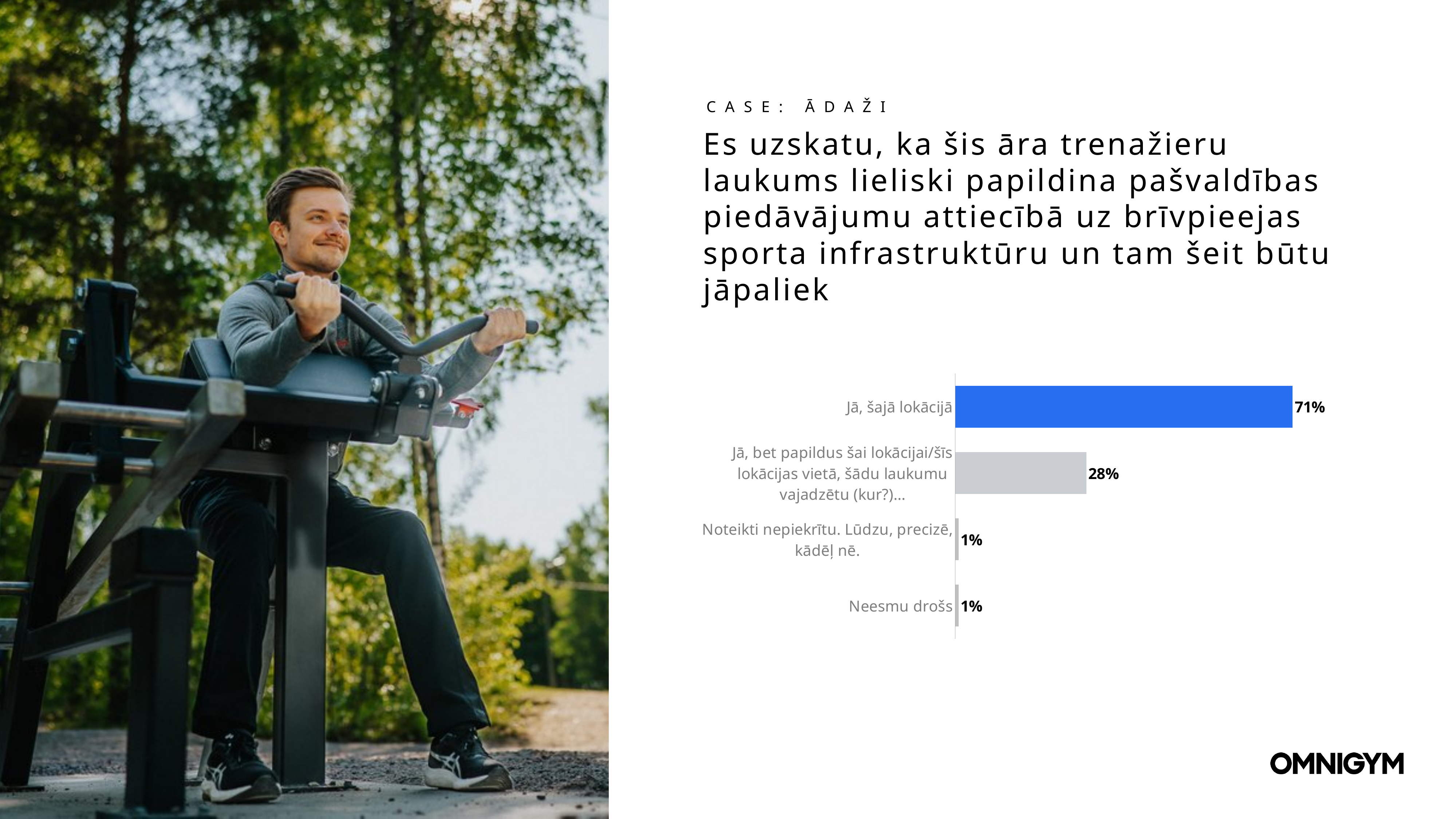
What is the value for "Noteikti nepiekrītu. Lūdzu, precizē, kādēļ nē."? 1% What kind of chart is shown on the slide? Bar chart Which case is named above the chart's statement? Ādaži What is the difference between the values for "Jā, šajā lokācijā" and "Jā, bet papildus šai lokācijai/šīs lokācijas vietā, šādu laukumu vajadzētu (kur?)..."? 43% What is the value for "Jā, bet papildus šai lokācijai/šīs lokācijas vietā, šādu laukumu vajadzētu (kur?)..."? 28% Which category has the highest value? Jā, šajā lokācijā What is the difference between the values for "Jā, bet papildus šai lokācijai/šīs lokācijas vietā, šādu laukumu vajadzētu (kur?)..." and "Neesmu drošs"? 27% What is the value for "Jā, šajā lokācijā"? 71% What is the value for "Neesmu drošs"? 1% Which is larger: the value for "Jā, šajā lokācijā" or the value for "Jā, bet papildus šai lokācijai/šīs lokācijas vietā, šādu laukumu vajadzētu (kur?)..."? Jā, šajā lokācijā What colour is the bar for "Jā, šajā lokācijā"? Blue How many categories does the chart show? 4